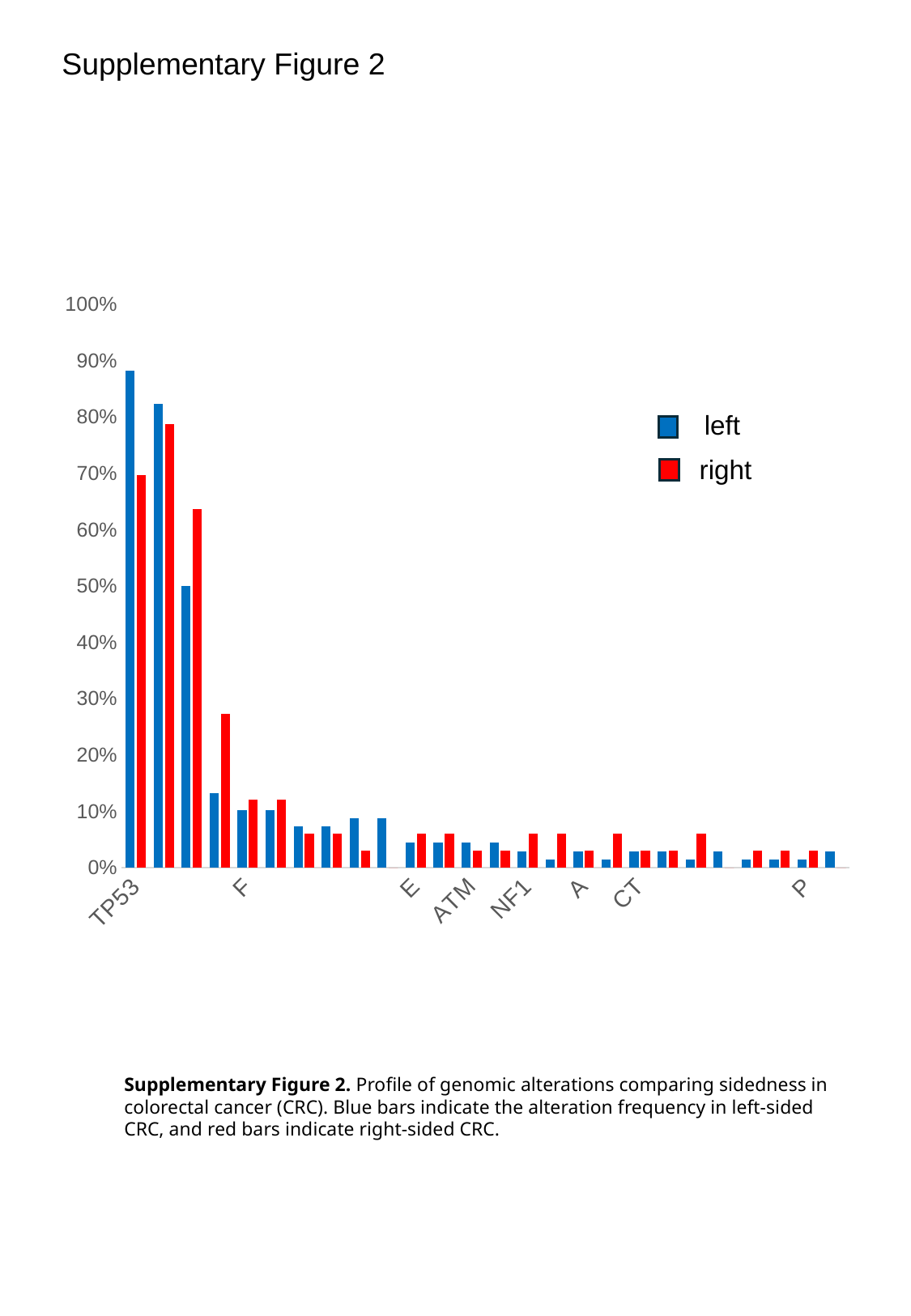
What are the two series named in the legend? left and right What colour are the bars for the 'right' series? red What kind of chart is shown on the slide? bar chart Which category has the highest value in the 'left' series? TP53 How many series does the legend list? 2 For TP53, which series has the larger value, left or right? left Do the 'left' series values generally rise or fall moving from left to right along the x axis? fall Is the 'right' value for TP53 greater or less than 80%? less Is the 'left' value for ATM greater or less than 10%? less Is the 'left' value for TP53 greater or less than 80%? greater For NF1, which series has the larger value, left or right? right